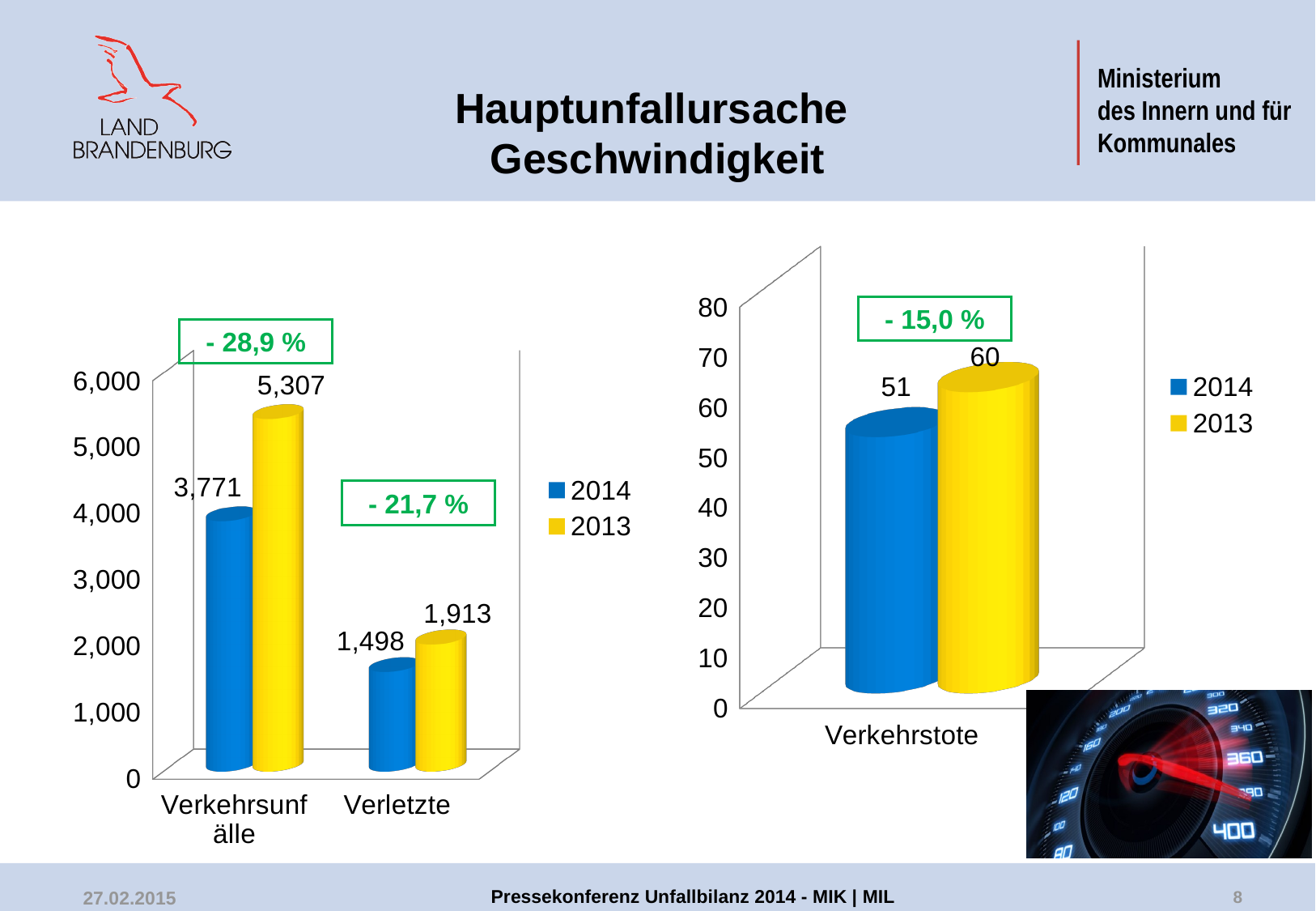
How many categories are shown on the x axis of the left chart? 2 In the left chart, what is the difference between the 2013 and 2014 values for Verkehrsunfälle? 1,536 In the left chart, what is the value for Verletzte in 2013? 1,913 In the right chart, what is the value for Verkehrstote in 2013? 60 How many series does the legend of the right chart list? 2 In the left chart, what is the value for Verkehrsunfälle in 2013? 5,307 What kind of chart is the right chart? Bar chart In the right chart, what is the difference between the 2013 and 2014 values for Verkehrstote? 9 In the left chart, which year has the larger value for Verletzte, 2014 or 2013? 2013 In the left chart, what is the difference between the 2013 and 2014 values for Verletzte? 415 In the left chart, what is the value for Verkehrsunfälle in 2014? 3,771 In the right chart, what is the value for Verkehrstote in 2014? 51